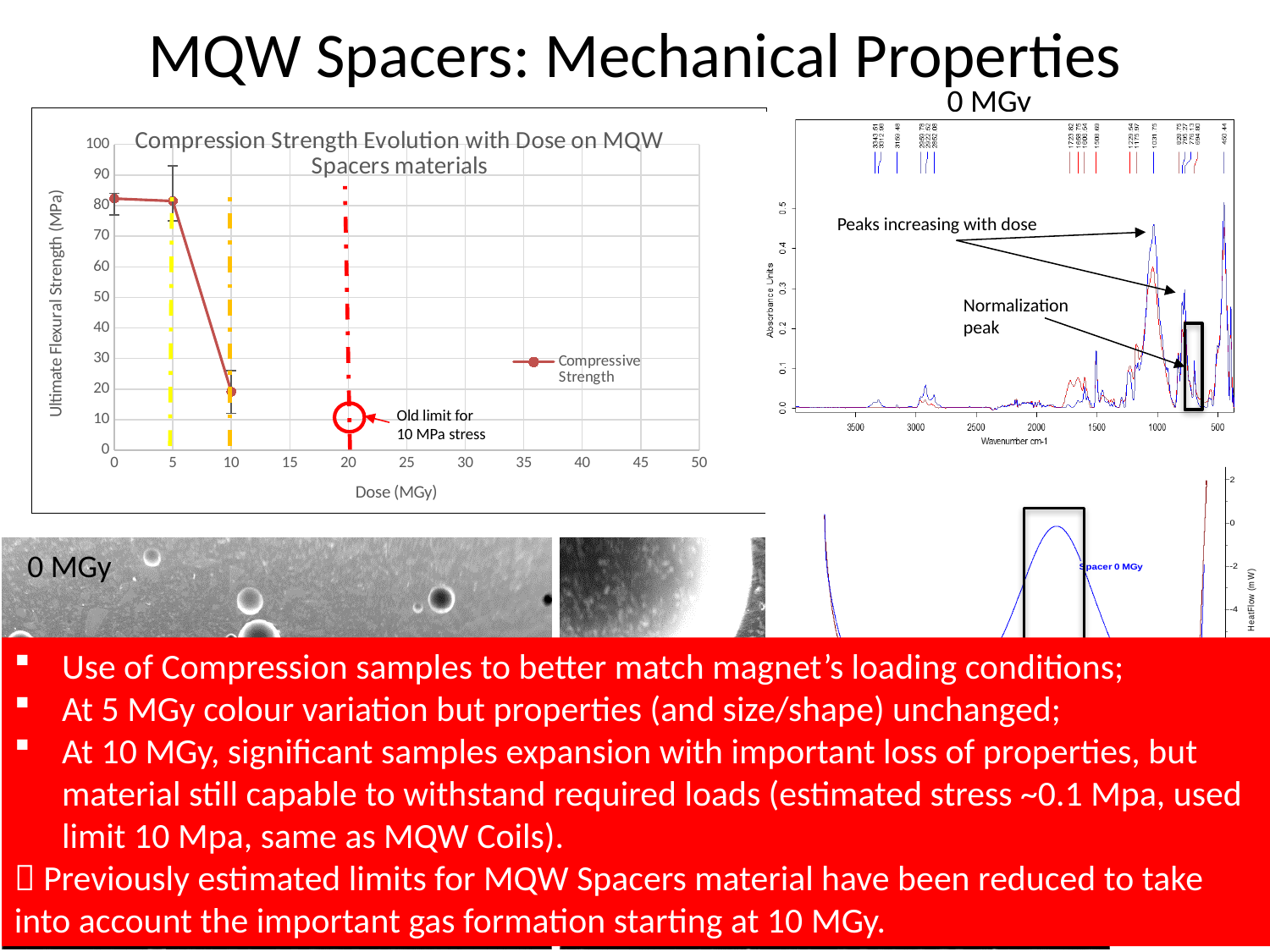
In the Compression Strength Evolution chart, is the value at 0 MGy greater or less than 70? greater In the Compression Strength Evolution chart, what is the x-axis title? Dose (MGy) In the Compression Strength Evolution chart, how many data points are plotted? 3 In the Compression Strength Evolution chart, at which dose is the plotted strength lowest? 10 MGy In the Compression Strength Evolution chart, is the value at 5 MGy greater or less than 60? greater In the Compression Strength Evolution chart, do the values rise or fall as dose increases from 0 to 10 MGy? fall In the Compression Strength Evolution chart, is the value at 10 MGy greater or less than 30? less In the Compression Strength Evolution chart, what kind of chart is it? Line chart In the Compression Strength Evolution chart, how many series does the legend list? 1 In the Compression Strength Evolution chart, what series name is shown in the legend? Compressive Strength In the Compression Strength Evolution chart, which is larger, the value at 5 MGy or the value at 10 MGy? 5 MGy